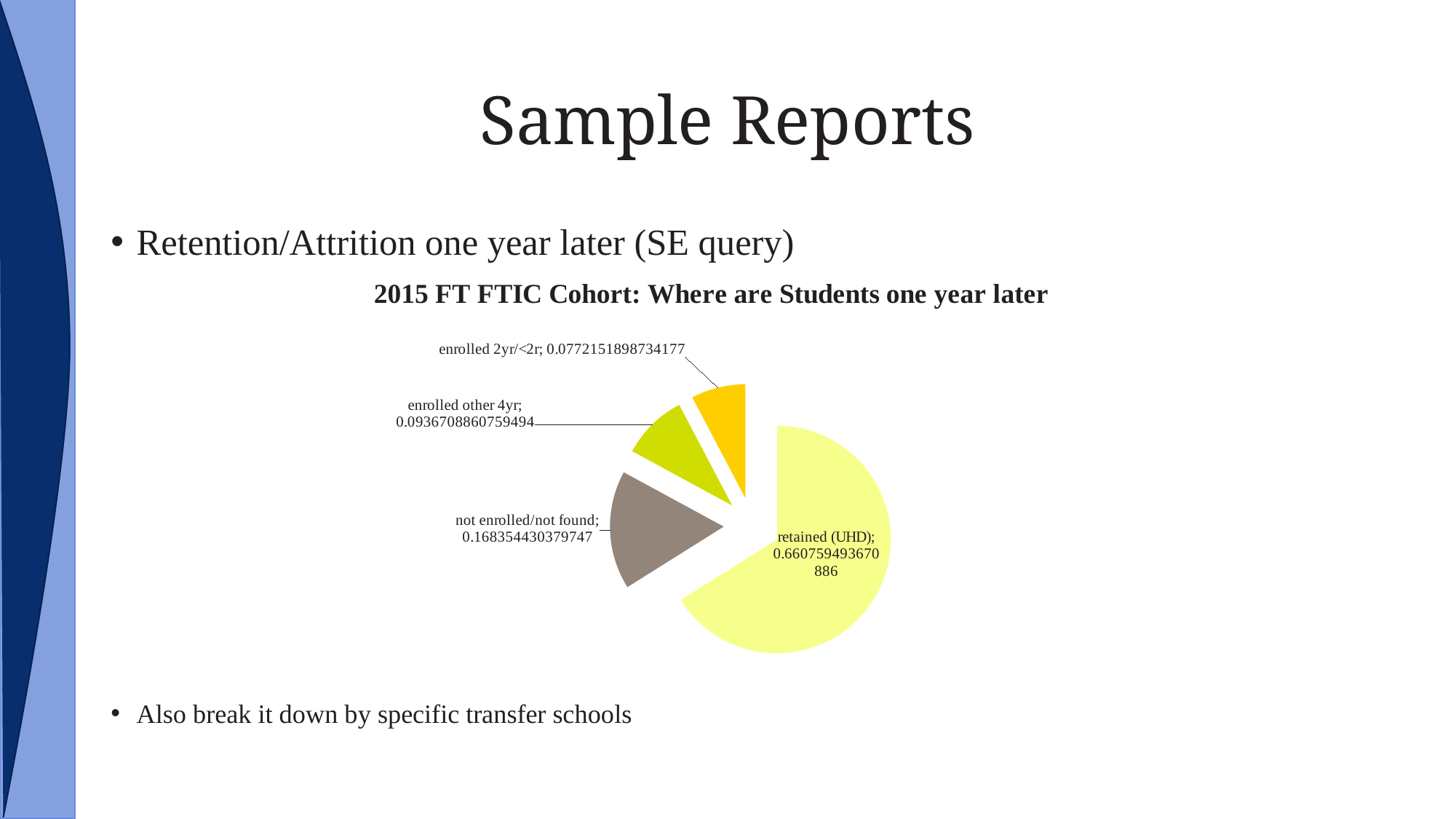
What colour is the not enrolled/not found slice? grey-brown Which category has the smallest slice of the pie? enrolled 2yr/<2r What value is shown for the enrolled other 4yr slice? 0.0936708860759494 Which category has the largest slice of the pie? retained (UHD) What value is shown for the not enrolled/not found slice? 0.168354430379747 What kind of chart is shown on the slide? pie chart Which is larger: the enrolled other 4yr slice or the enrolled 2yr/<2r slice? enrolled other 4yr What is the title of the chart? 2015 FT FTIC Cohort: Where are Students one year later What value is shown for the enrolled 2yr/<2r slice? 0.0772151898734177 What is the difference between the retained (UHD) value and the not enrolled/not found value? 0.492405063291139 What value is shown for the retained (UHD) slice in the pie chart? 0.660759493670886 How many slices does the pie chart have? 4